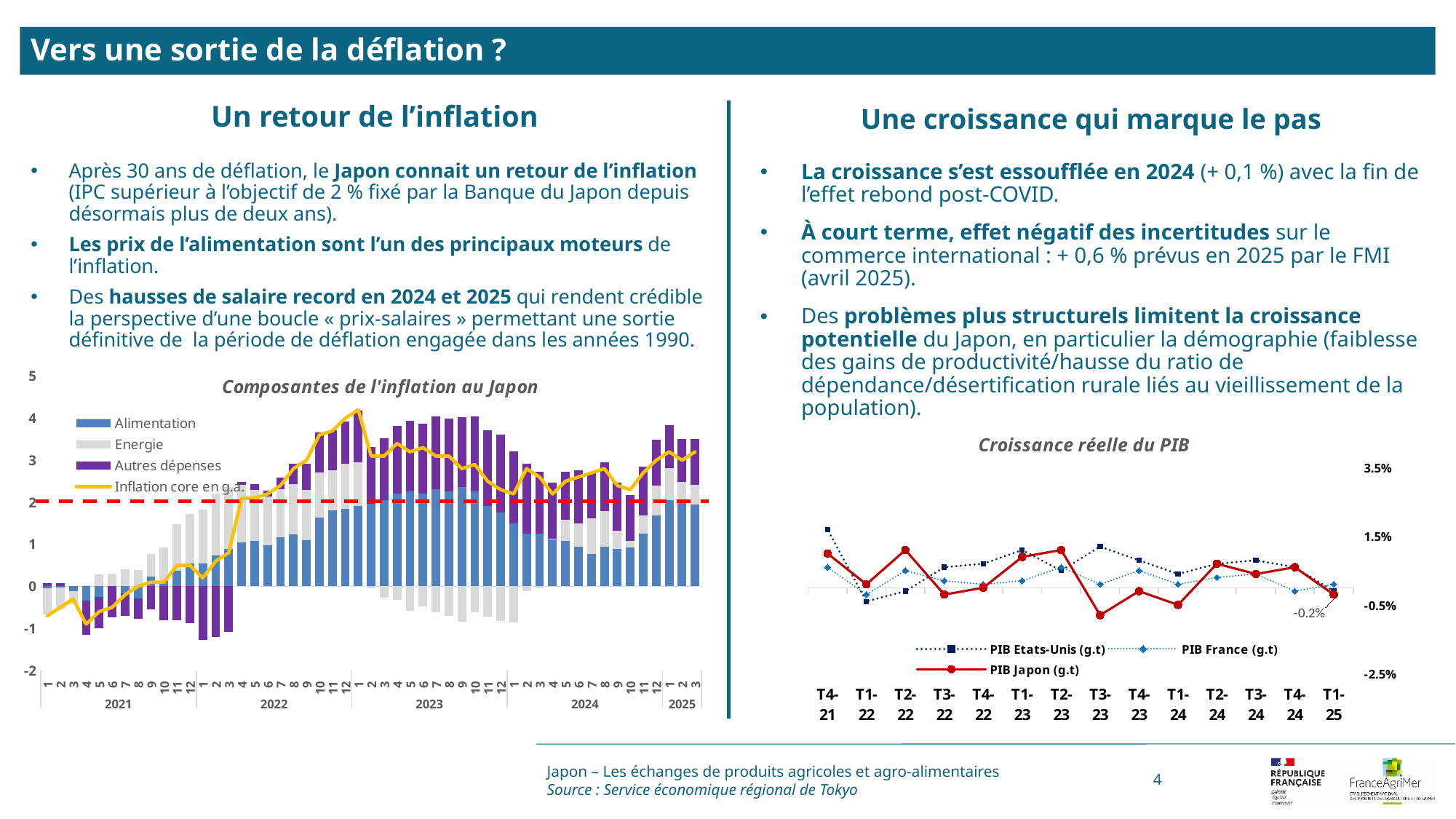
In 'Composantes de l'inflation au Japon', is the 'Inflation core en g.a.' line at month 1 of 2021 greater or less than 0? less In 'Croissance réelle du PIB', at T3-23, which is higher: PIB Etats-Unis (g.t) or PIB Japon (g.t)? PIB Etats-Unis (g.t) In 'Croissance réelle du PIB', is the value of PIB Japon (g.t) at T3-23 greater or less than -0.5%? less What kind of chart is 'Composantes de l'inflation au Japon'? A stacked bar chart with a line overlay How many series does the legend of 'Composantes de l'inflation au Japon' list? 4 What kind of chart is 'Croissance réelle du PIB'? Line chart In 'Composantes de l'inflation au Japon', does the 'Inflation core en g.a.' line rise or fall from the start of 2021 to the start of 2023? Rise How many series does the legend of 'Croissance réelle du PIB' list? 3 In 'Croissance réelle du PIB', at which quarter is PIB Japon (g.t) at its lowest? T3-23 In 'Croissance réelle du PIB', what is the value of PIB Japon (g.t) at T1-25? -0.2% How many quarters are shown on the x axis of 'Croissance réelle du PIB'? 14 In 'Composantes de l'inflation au Japon', at what level on the y axis is the red dashed horizontal line drawn? 2